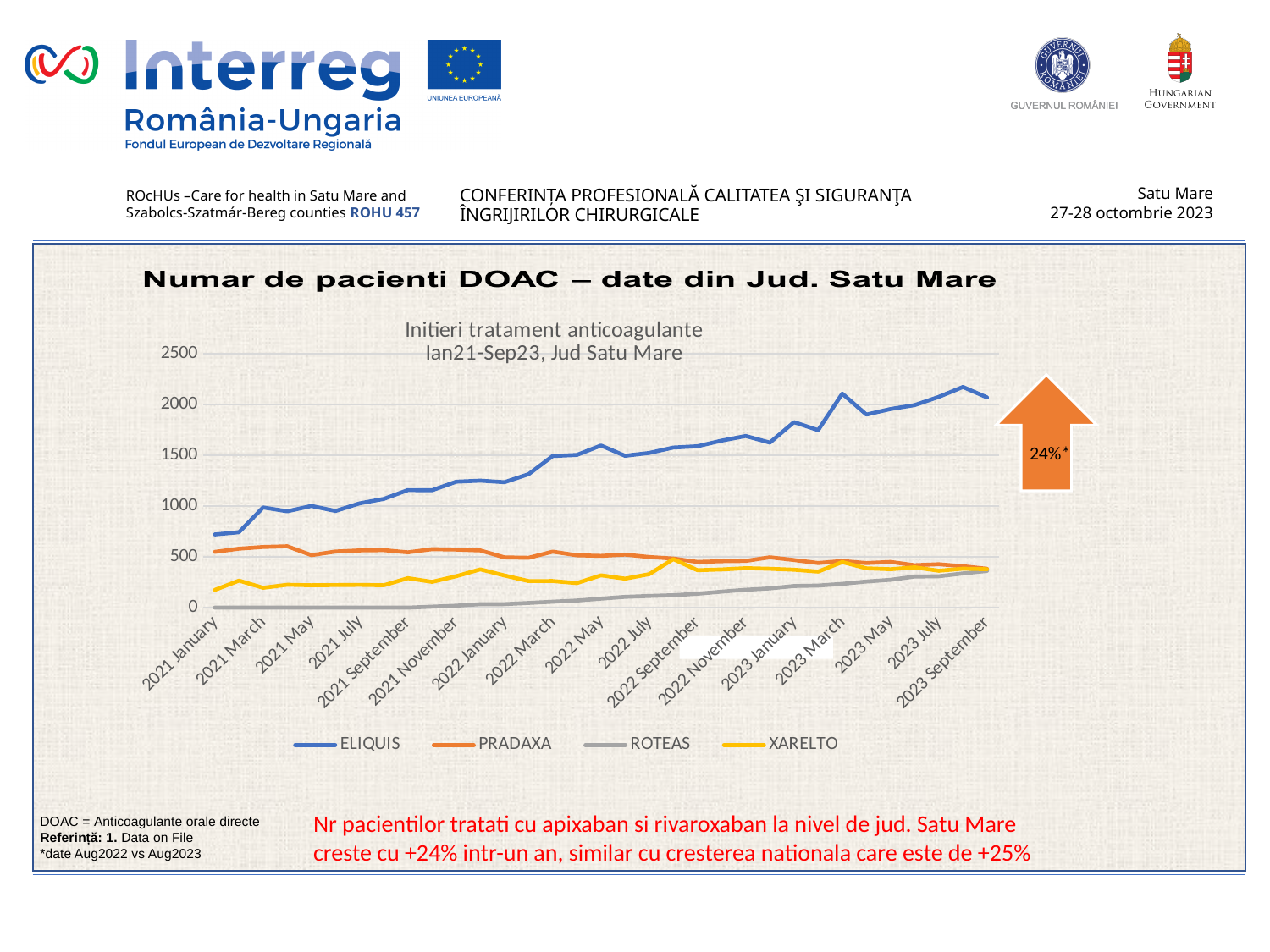
Does the ELIQUIS series rise or fall from 2021 January to 2023 September? rise What kind of chart is shown on the slide? line chart Does the PRADAXA series rise or fall from 2021 January to 2023 September? fall Which is larger in 2023 September, ELIQUIS or PRADAXA? ELIQUIS Is the value for ELIQUIS in 2021 January greater or less than 1000? less Is the value for ELIQUIS in 2023 July greater or less than 1500? greater Which series has the lowest value in 2021 January? ROTEAS What is the title of the chart? Initieri tratament anticoagulante Ian21-Sep23, Jud Satu Mare How many series does the legend list? 4 Which series has the highest value in 2023 September? ELIQUIS Is the value for PRADAXA in 2021 January greater or less than 1000? less